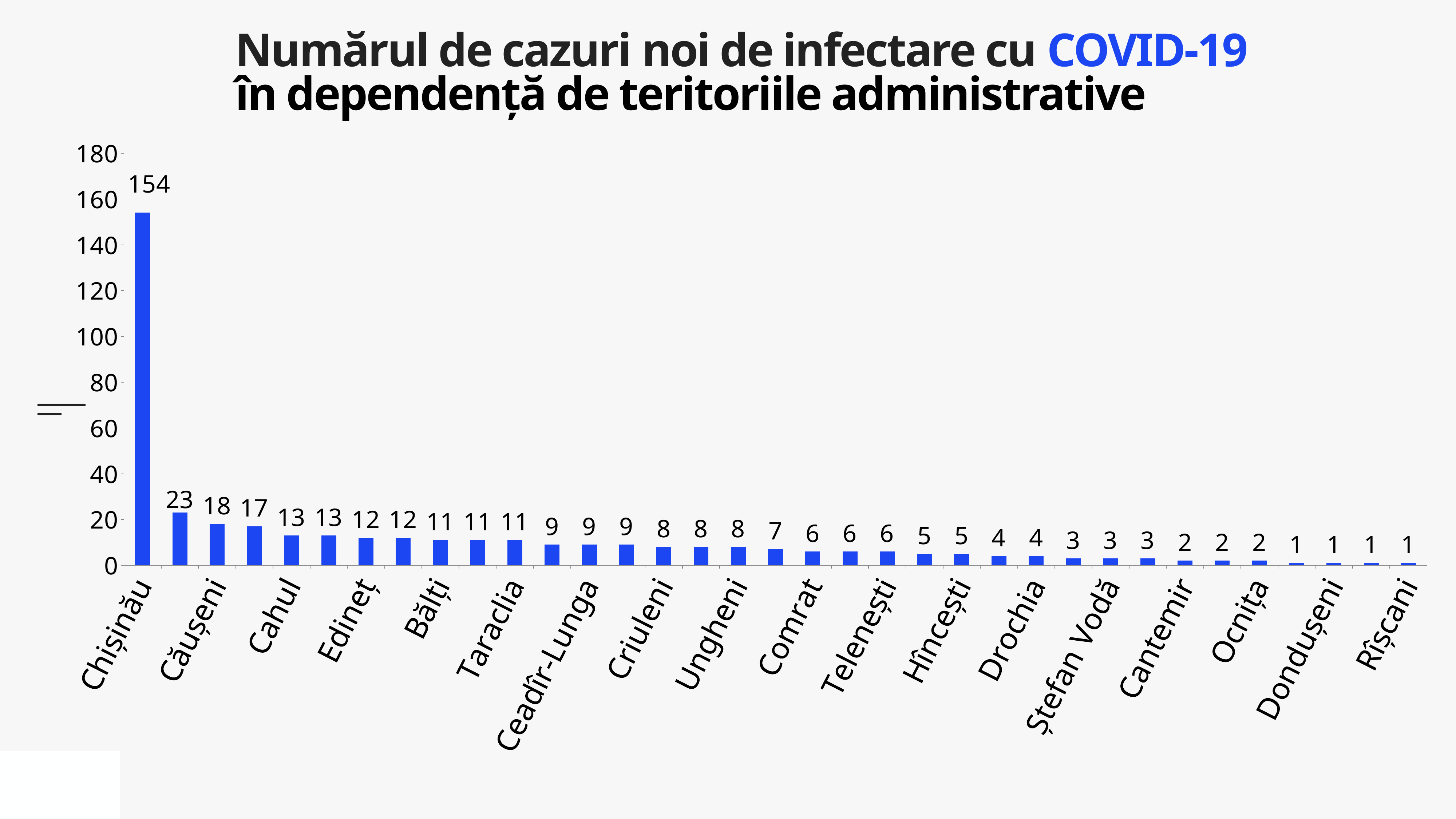
What is the second highest value shown on the chart? 23 What is the difference between the values for Chișinău and Rîșcani? 153 Which territory has the highest number of new cases? Chișinău Is the value for Chișinău greater or less than 140? greater Which is larger, the value for Chișinău or the value for Căușeni? Chișinău How many bars are plotted on the chart? 35 What is the highest value shown on the chart? 154 What is the highest tick value shown on the vertical axis? 180 Do the values rise or fall from left to right along the x axis? fall What is the value for Chișinău? 154 What kind of chart is shown on the slide? bar chart What is the value for Rîșcani, the last bar on the chart? 1